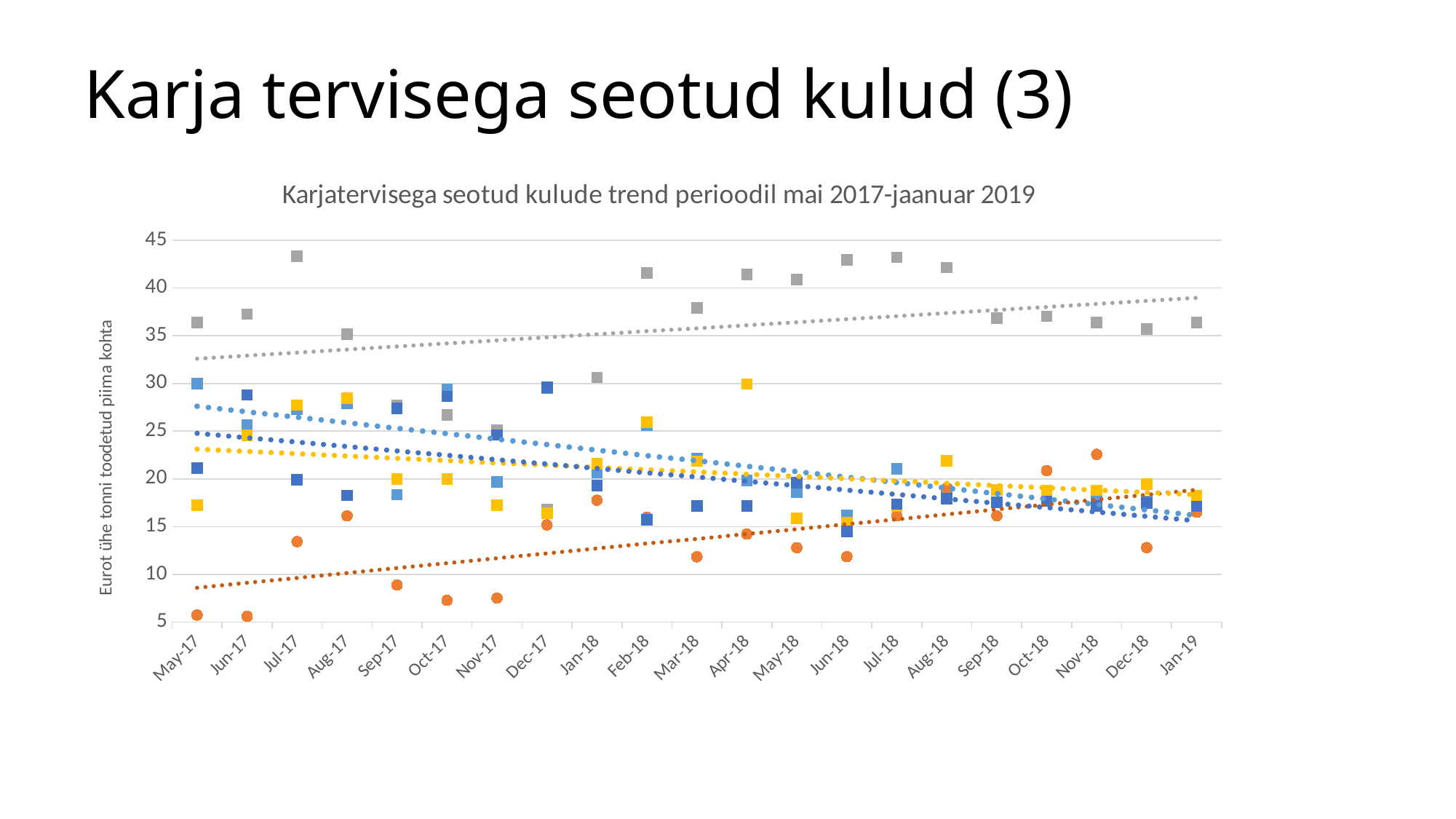
How many months are shown along the x axis? 21 In which month is the grey square series at its lowest? Dec-17 Does the dotted trend line for the orange circle series rise or fall from May-17 to Jan-19? rise Is the value of the orange circle at May-17 greater or less than 10? less Does the dotted trend line for the grey square series rise or fall from May-17 to Jan-19? rise What kind of chart is shown on the slide? scatter chart Which is larger: the grey square value at Jul-17 or the grey square value at May-17? Jul-17 What is the label of the vertical axis? Eurot ühe tonni toodetud piima kohta Is the value of the grey square at Dec-17 greater or less than 20? less Does the dotted trend line for the light blue square series rise or fall from May-17 to Jan-19? fall Is the value of the grey square at Jul-17 greater or less than 40? greater What is the title of the chart? Karjatervisega seotud kulude trend perioodil mai 2017-jaanuar 2019